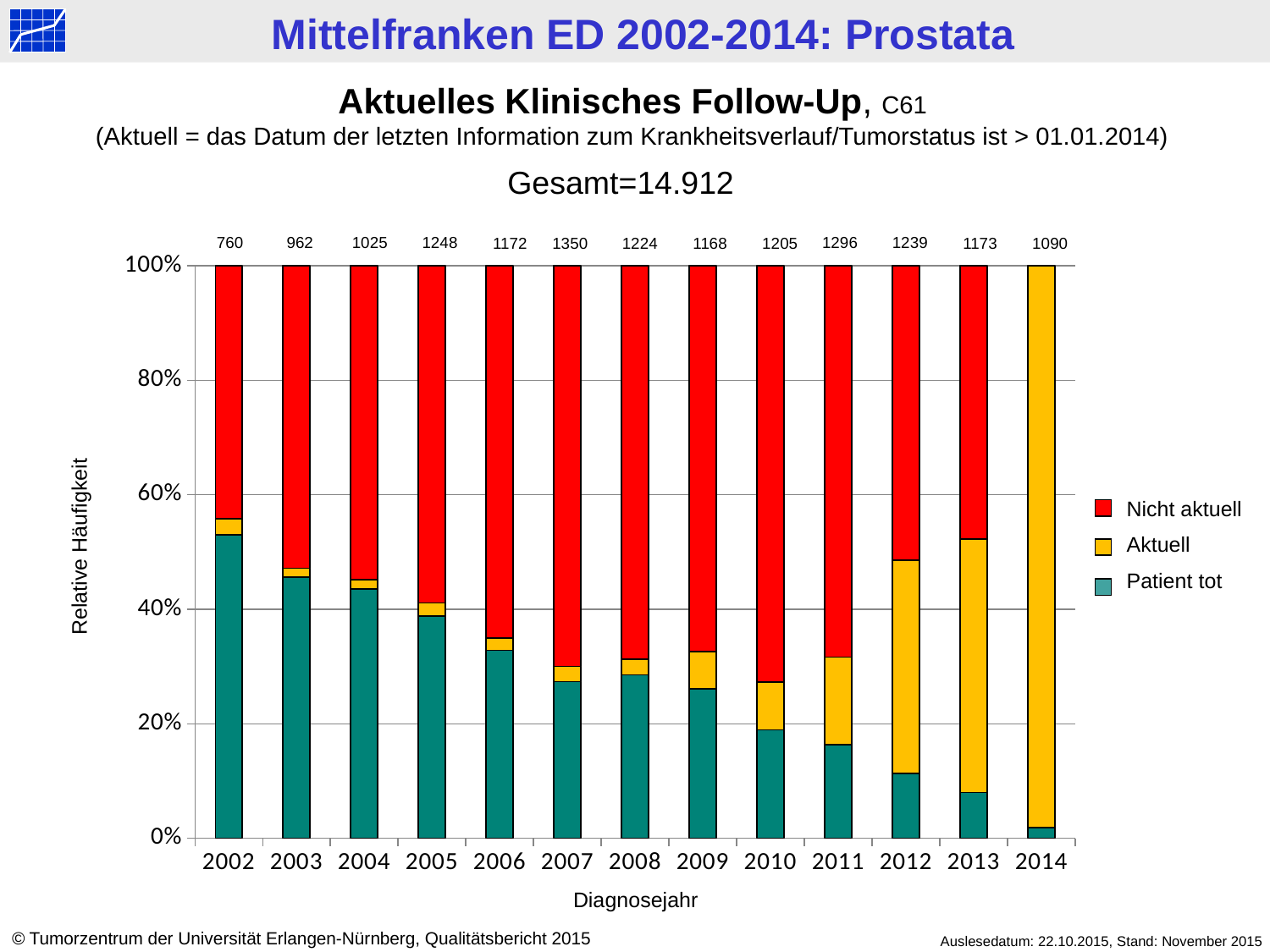
How many diagnosis years are shown on the x axis? 13 What kind of chart is shown on the slide? Stacked bar chart How many series does the legend list? 3 Which has the larger number printed above its bar, 2011 or 2012? 2011 Which diagnosis year has the highest number printed above its bar? 2007 Which diagnosis year has the lowest number printed above its bar? 2002 What number is printed above the bar for 2007? 1350 Is the 'Patient tot' share for 2002 greater or less than 40%? greater Does the 'Patient tot' share rise or fall from 2002 to 2014? Fall What is the difference between the numbers printed above the bars for 2005 and 2004? 223 Is the 'Patient tot' share for 2014 greater or less than 20%? less What number is printed above the bar for 2002? 760